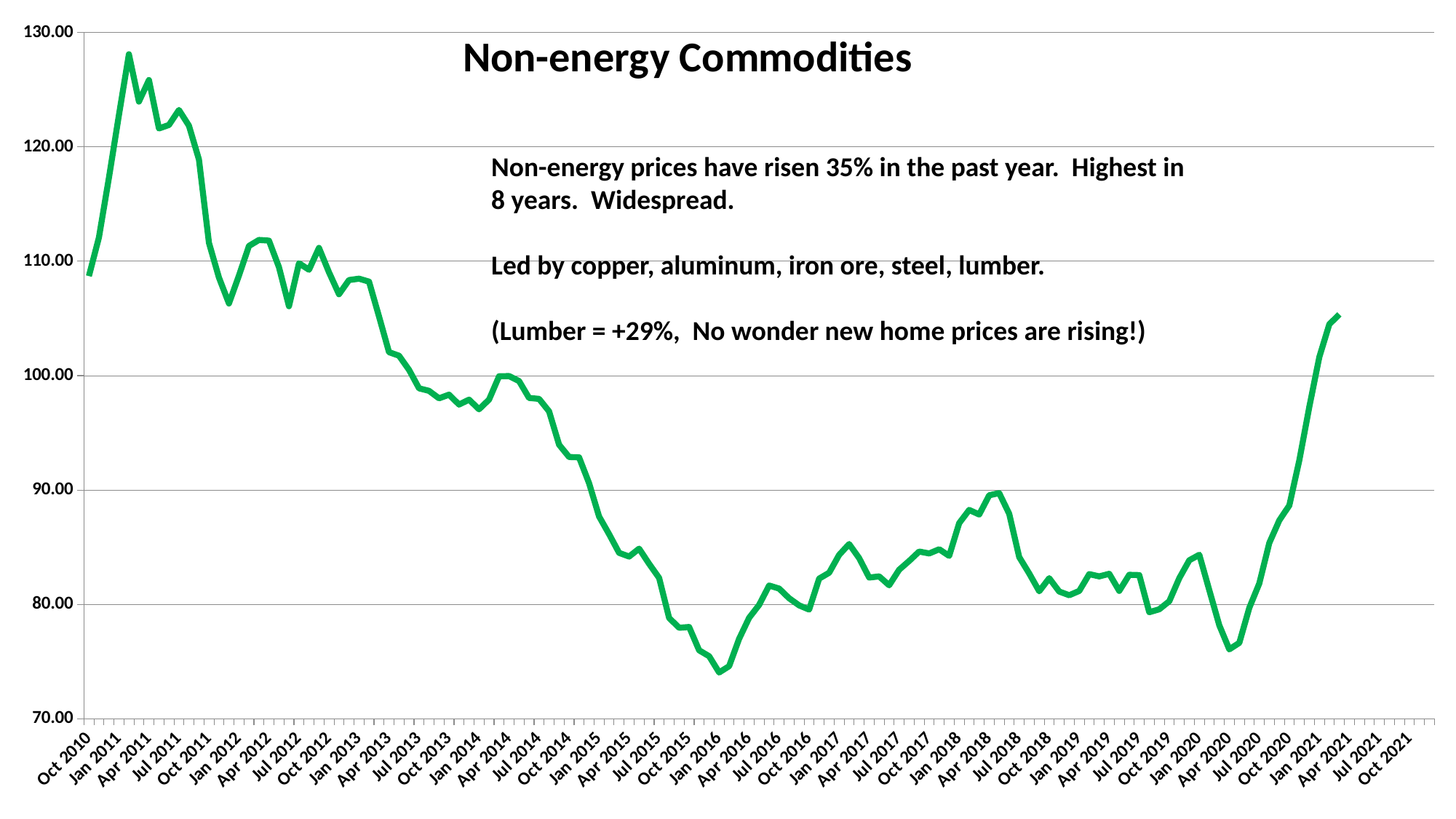
Is the value for Jan 2016 greater or less than 80? less Which is higher, the value for Jan 2011 or the value for Jan 2021? Jan 2011 What colour is the line in the chart? green Is the value for Jan 2014 greater or less than 100? less Is the value for Oct 2010 greater or less than 110? less Does the line rise or fall between Jul 2020 and Apr 2021? rise In which year does the line reach its lowest value? 2016 In which year does the line reach its highest value? 2011 What kind of chart is shown on the slide? line chart What is the title of the chart? Non-energy Commodities